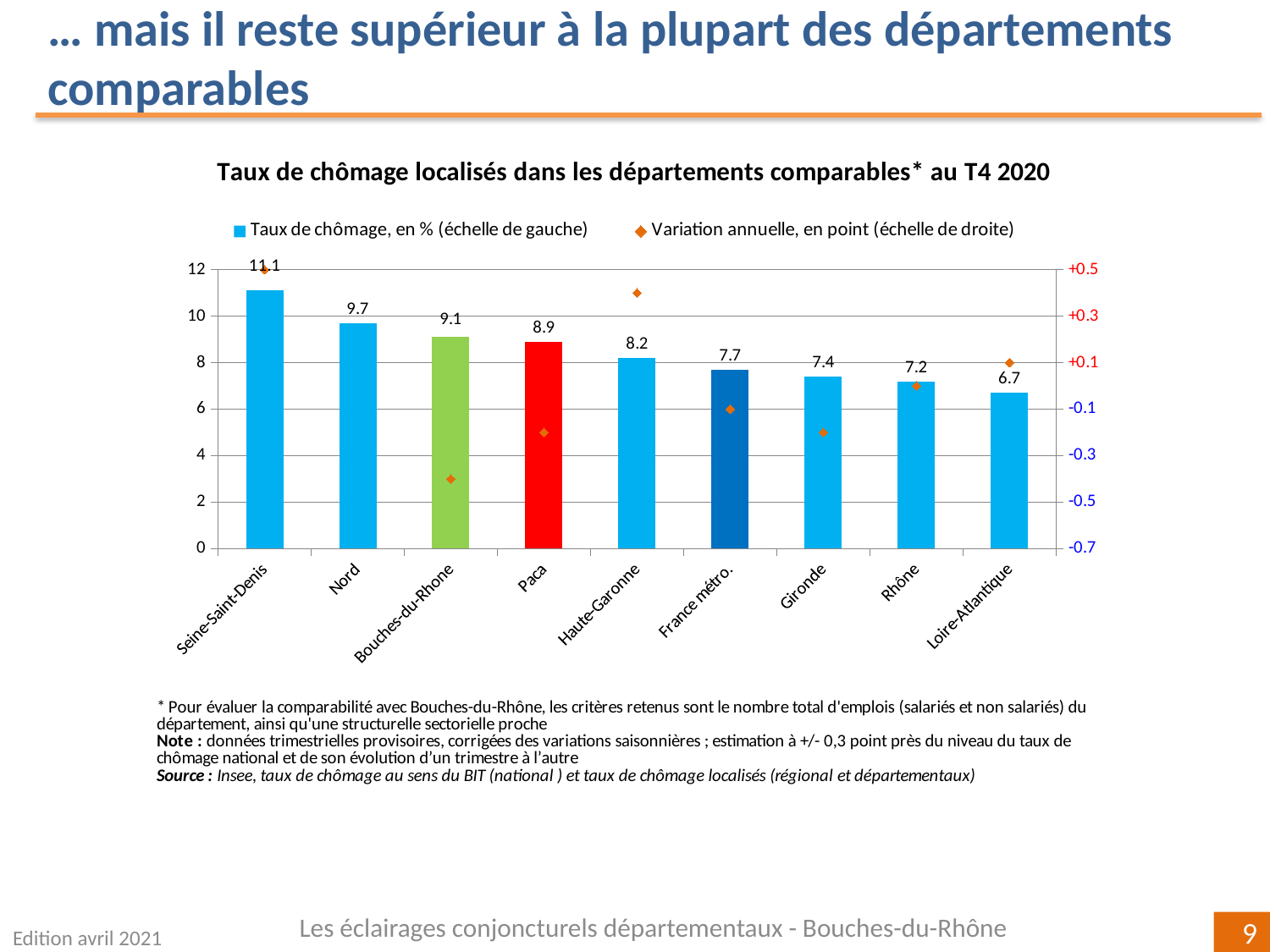
What is the difference between the unemployment rates of Bouches-du-Rhône and France métro.? 1.4 Which department has the highest unemployment rate in the chart? Seine-Saint-Denis What is the unemployment rate shown for Bouches-du-Rhône? 9.1 What is the unemployment rate shown for Seine-Saint-Denis? 11.1 Which has a higher unemployment rate, Nord or Paca? Nord Which department has the lowest unemployment rate in the chart? Loire-Atlantique Is the annual variation (right axis) for Haute-Garonne greater or less than +0.3? greater How many departments or areas are shown on the x axis? 9 Is the annual variation (right axis) for Bouches-du-Rhône greater or less than -0.3? less What is the unemployment rate shown for France métro.? 7.7 How many series does the legend list? 2 What is the title of the chart? Taux de chômage localisés dans les départements comparables* au T4 2020